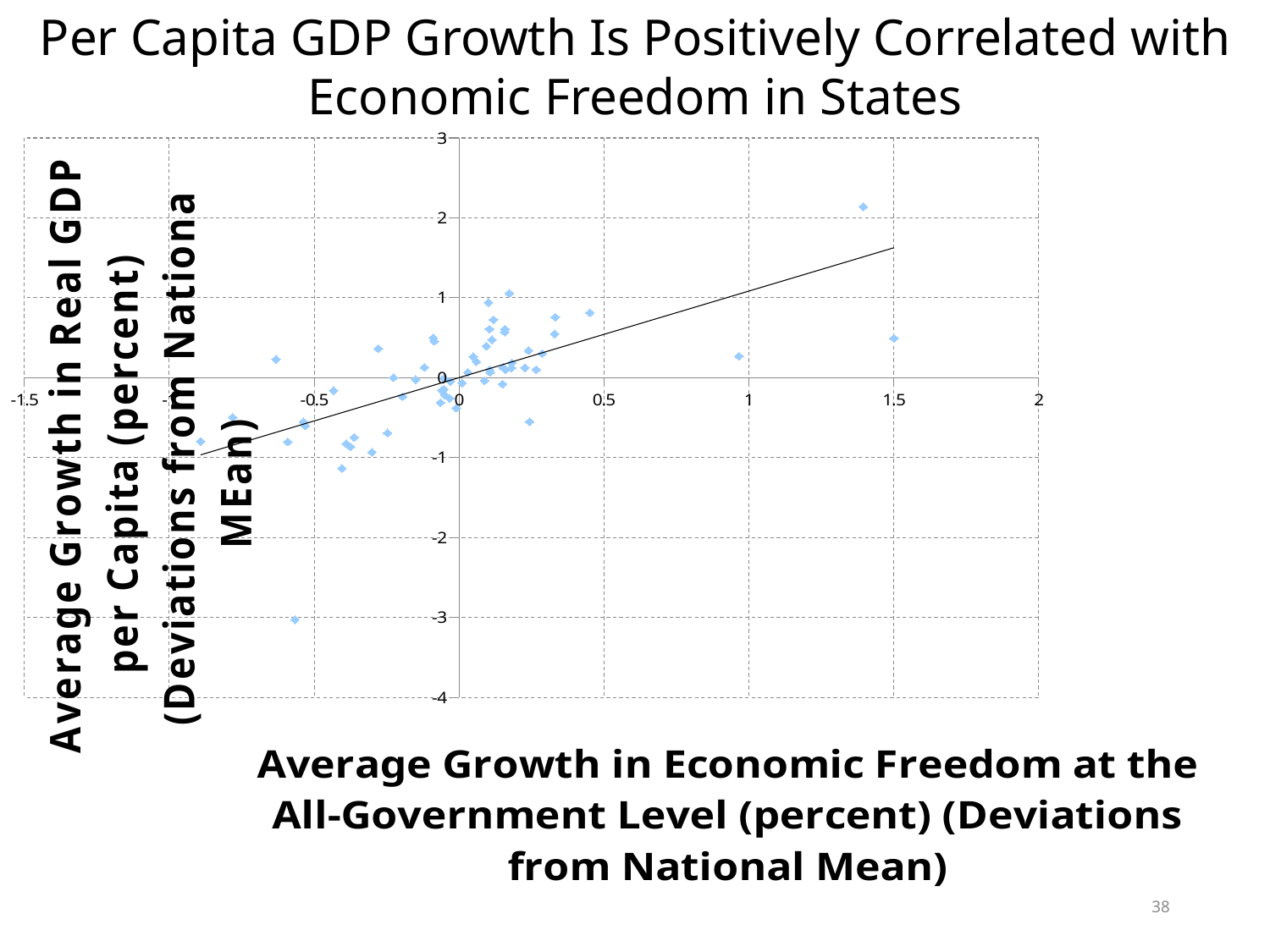
Is the y value of the rightmost point on the chart greater or less than 1? less Do the plotted points generally rise or fall as the x-axis value increases? rise Is the y value of the lowest point on the chart greater or less than -2? less Is the x value of the highest point on the chart greater or less than 1? greater What kind of chart is shown on the slide? scatter plot Does the fitted line on the chart slope upward or downward from left to right? upward What is the label of the x-axis? Average Growth in Economic Freedom at the All-Government Level (percent) (Deviations from National Mean) What is the title of the chart? Per Capita GDP Growth Is Positively Correlated with Economic Freedom in States